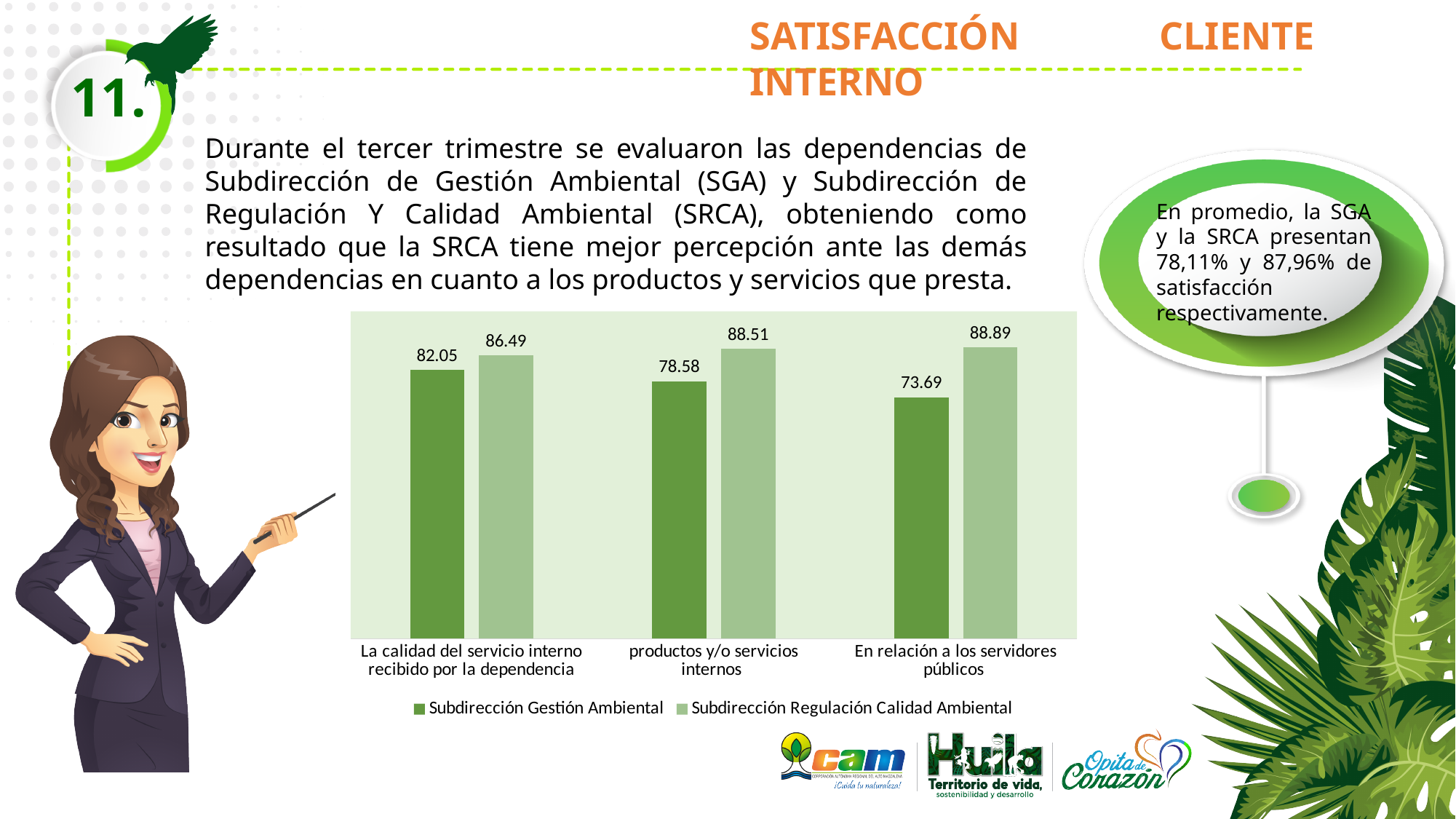
What kind of chart is shown on the slide? Bar chart How many categories are shown on the x axis of the chart? 3 Which category has the highest value for Subdirección Regulación Calidad Ambiental? En relación a los servidores públicos What is the value for Subdirección Gestión Ambiental in the category 'En relación a los servidores públicos'? 73.69 What is the difference between the two series in the category 'En relación a los servidores públicos'? 15.2 In the category 'productos y/o servicios internos', which series has the larger value? Subdirección Regulación Calidad Ambiental What is the value for Subdirección Gestión Ambiental in the category 'La calidad del servicio interno recibido por la dependencia'? 82.05 Which category has the lowest value for Subdirección Gestión Ambiental? En relación a los servidores públicos What is the value for Subdirección Regulación Calidad Ambiental in the category 'productos y/o servicios internos'? 88.51 How many series does the chart legend list? 2 What is the difference between the two series in the category 'La calidad del servicio interno recibido por la dependencia'? 4.44 What is the value for Subdirección Regulación Calidad Ambiental in the category 'En relación a los servidores públicos'? 88.89